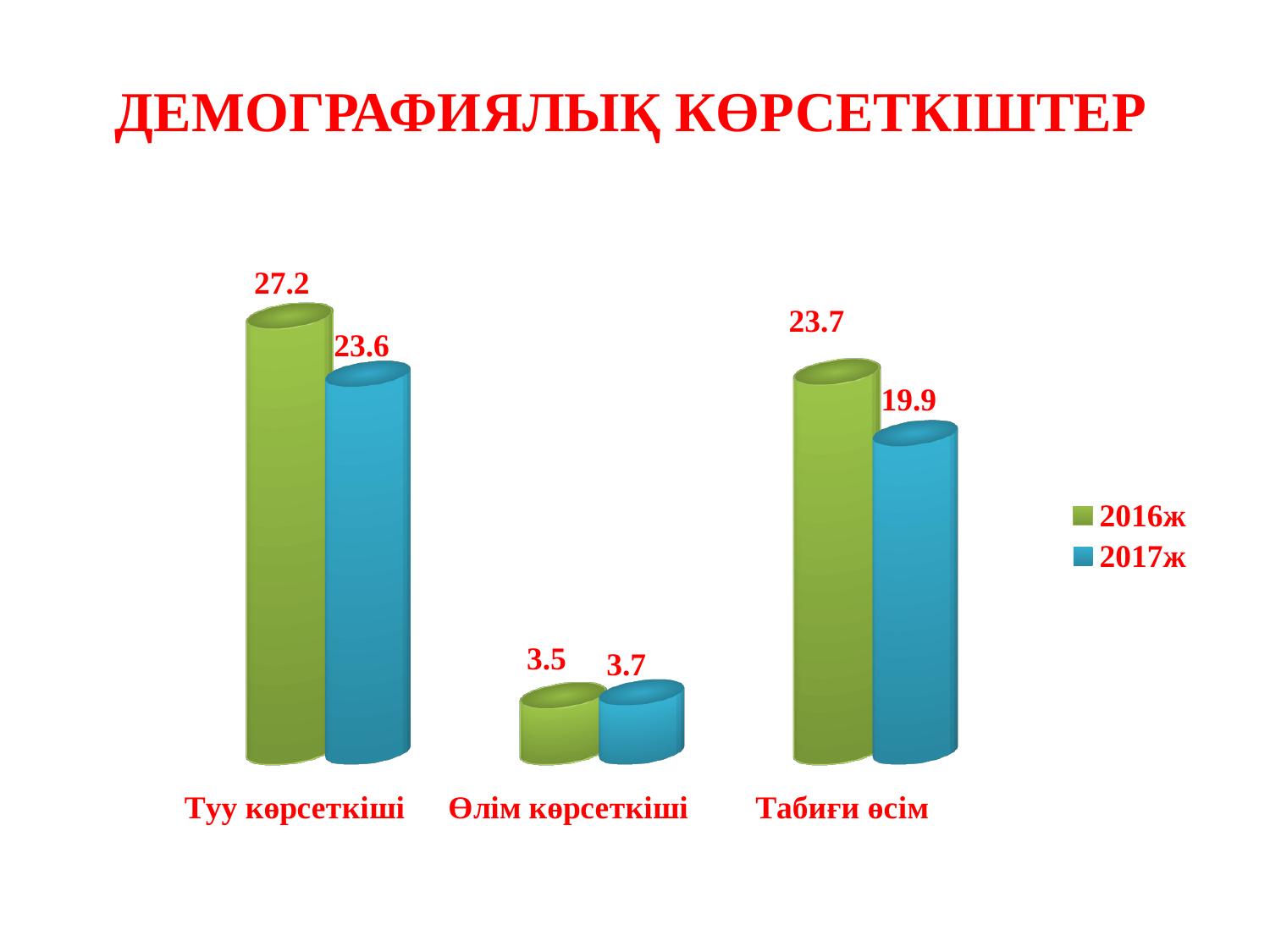
What is the difference between the 2016ж and 2017ж values for Туу көрсеткіші? 3.6 What kind of chart is shown on the slide? Bar chart How many series does the legend list? 2 What is the value for Туу көрсеткіші in 2017ж? 23.6 For Өлім көрсеткіші, which year has the larger value, 2016ж or 2017ж? 2017ж Which category has the lowest value for 2017ж? Өлім көрсеткіші Which category has the highest value for 2016ж? Туу көрсеткіші What is the value for Өлім көрсеткіші in 2017ж? 3.7 How many categories are shown on the x axis? 3 What is the value for Туу көрсеткіші in 2016ж? 27.2 What is the value for Табиғи өсім in 2016ж? 23.7 What is the difference between the 2016ж and 2017ж values for Табиғи өсім? 3.8